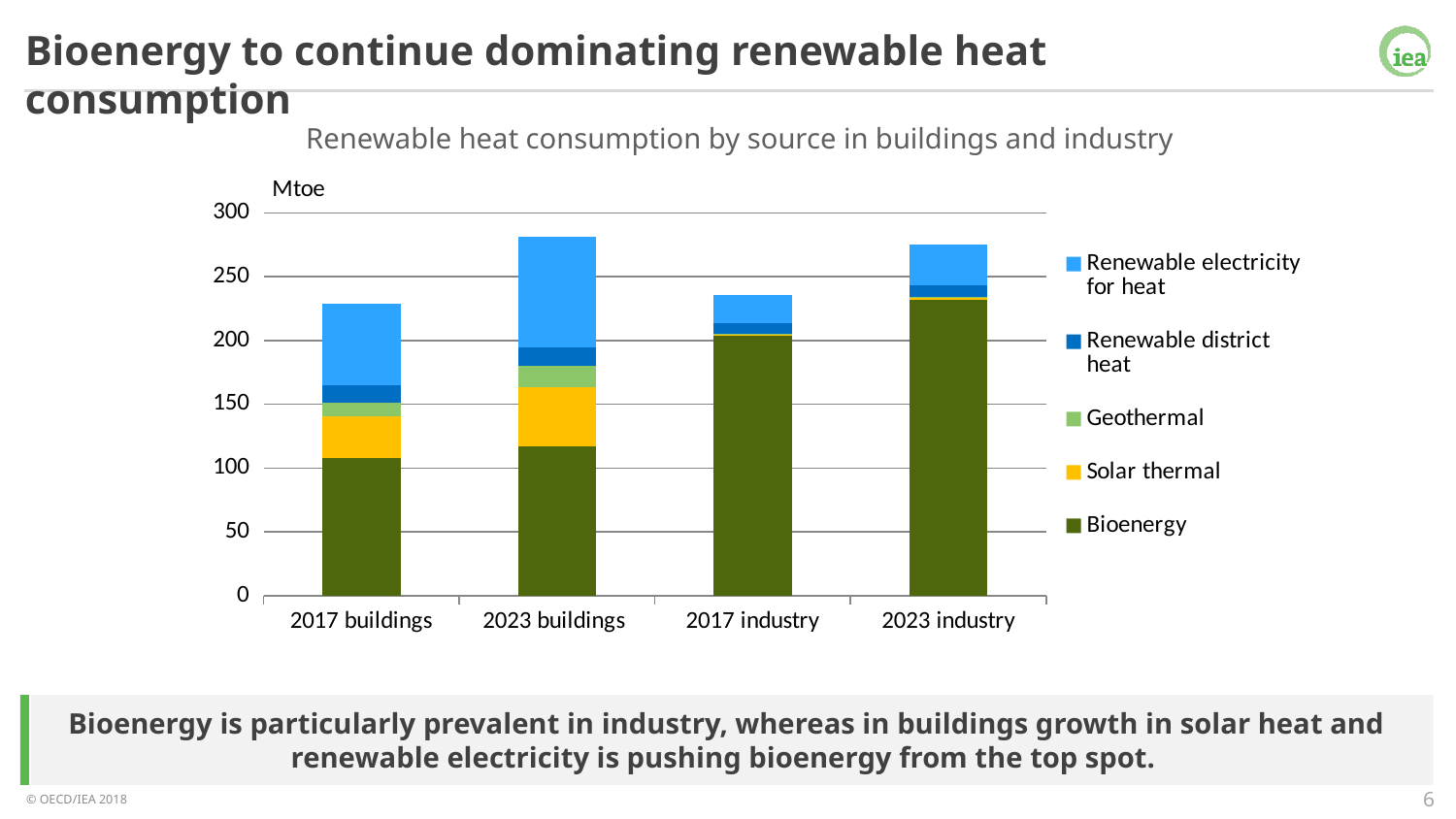
Does the Bioenergy value for industry rise or fall from 2017 to 2023? rise What is the title of the chart? Renewable heat consumption by source in buildings and industry Is the total value for 2023 buildings greater or less than 250? greater Is the total value for 2017 buildings greater or less than 250? less What kind of chart is shown on the slide? Stacked bar chart How many categories are shown on the x axis of the chart? 4 How many series does the chart's legend list? 5 Is the Bioenergy value for 2017 buildings greater or less than 150? less Which has the larger Solar thermal value, 2017 buildings or 2023 buildings? 2023 buildings What unit is shown on the chart's vertical axis? Mtoe